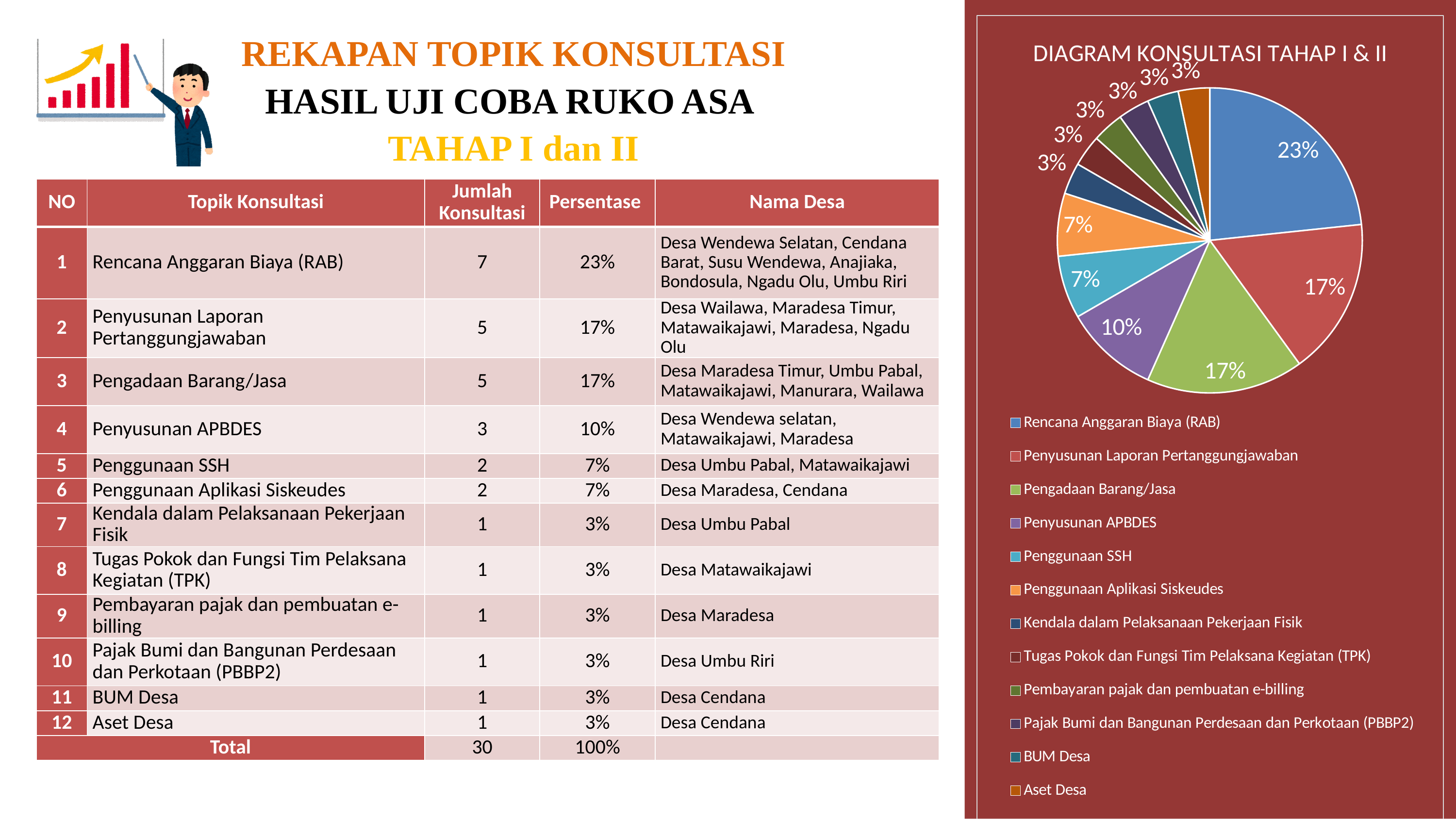
Which category has the largest slice in the pie chart? Rencana Anggaran Biaya (RAB) How many slices does the pie chart have? 12 How many entries does the legend of the pie chart list? 12 Which slice is larger in the pie chart, Penyusunan APBDES or Penggunaan Aplikasi Siskeudes? Penyusunan APBDES What share of the pie chart does BUM Desa take? 3% What is the difference in percentage points between the Rencana Anggaran Biaya (RAB) slice and the Penyusunan APBDES slice? 13% What kind of chart is shown on the slide? pie chart What is the title of the chart on the slide? DIAGRAM KONSULTASI TAHAP I & II What share of the pie chart does Pengadaan Barang/Jasa take? 17% What share of the pie chart does Penggunaan SSH take? 7%